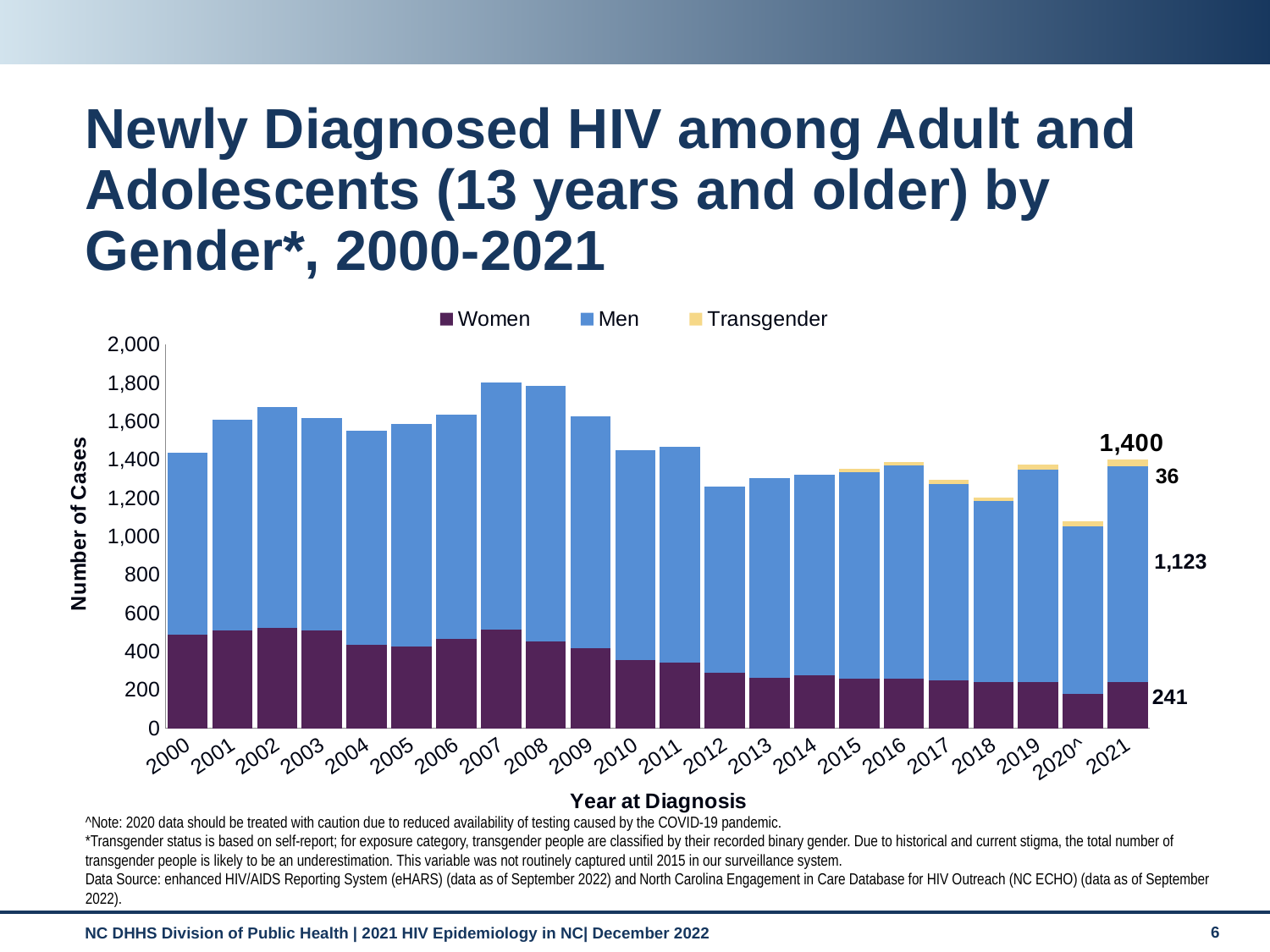
What is the number of cases for Transgender in 2021? 36 What is the number of cases for Women in 2021? 241 How many series does the legend list? 3 What is the title of the y axis? Number of Cases Is the total number of cases in 2020^ greater or less than 1,200? less Is the total number of cases in 2007 greater or less than 1,600? greater What is the total number of cases for the 2021 bar? 1,400 What is the difference between the Men and Women values in 2021? 882 How many years are shown along the x axis? 22 Which year has the lowest total number of cases? 2020^ What is the number of cases for Men in 2021? 1,123 What kind of chart is shown on the slide? Stacked bar chart